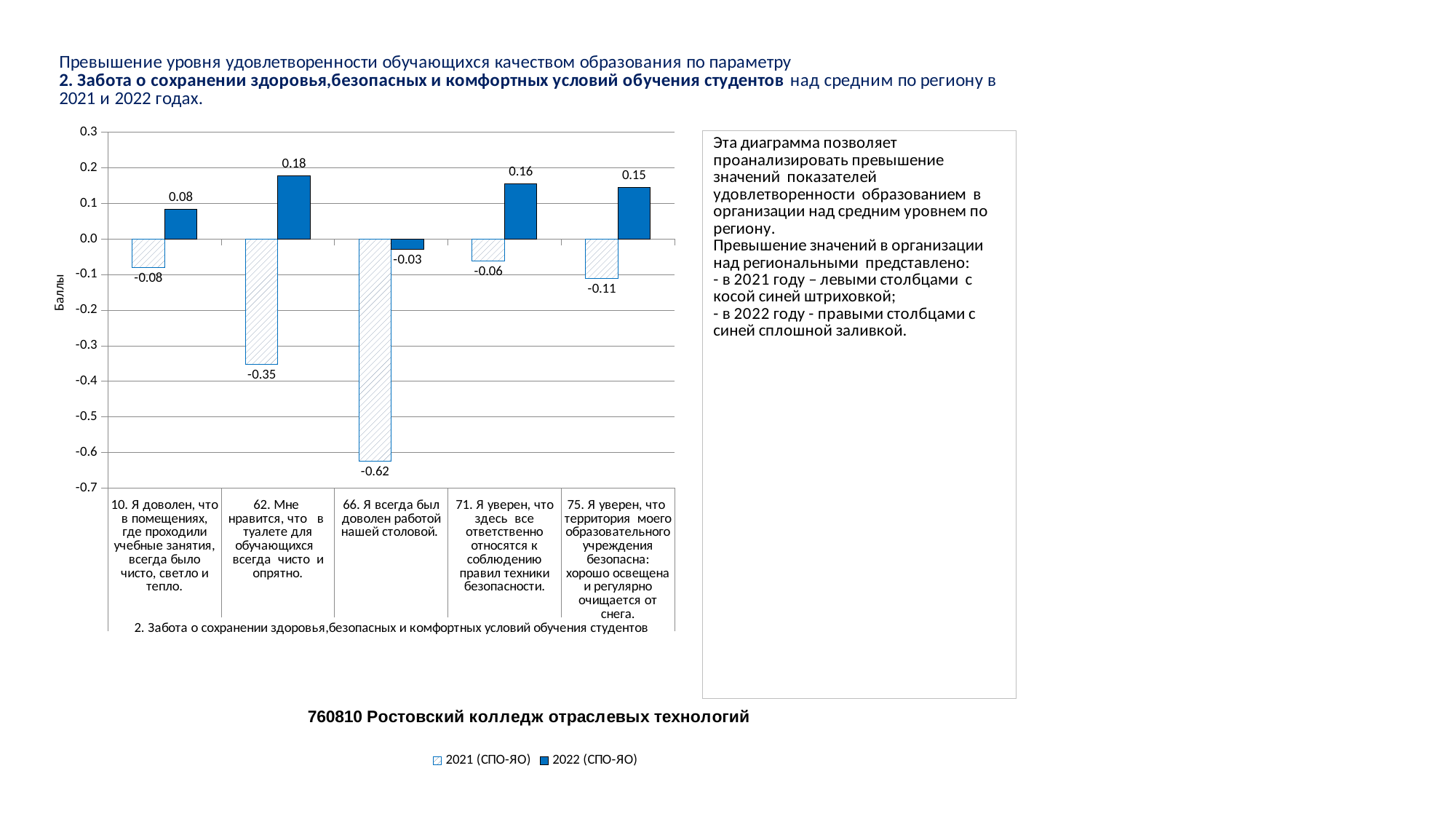
Is the 2021 (СПО-ЯО) value for question 62 greater or less than -0.3? less What is the 2022 (СПО-ЯО) value for question 75 (Я уверен, что территория моего образовательного учреждения безопасна)? 0.15 Which category has the lowest 2021 (СПО-ЯО) value? 66. Я всегда был доволен работой нашей столовой. What is the label of the y axis? Баллы Which category has the highest 2022 (СПО-ЯО) value? 62. Мне нравится, что в туалете для обучающихся всегда чисто и опрятно. How many categories (questions) are shown on the x axis? 5 What is the 2022 (СПО-ЯО) value for question 62 (Мне нравится, что в туалете для обучающихся всегда чисто и опрятно)? 0.18 Which is larger for question 10: the 2021 (СПО-ЯО) value or the 2022 (СПО-ЯО) value? 2022 (СПО-ЯО) What is the difference between the 2022 and 2021 values for question 62? 0.53 What is the 2021 (СПО-ЯО) value for question 66 (Я всегда был доволен работой нашей столовой)? -0.62 What type of chart is shown on the slide? bar chart How many series does the legend list? 2